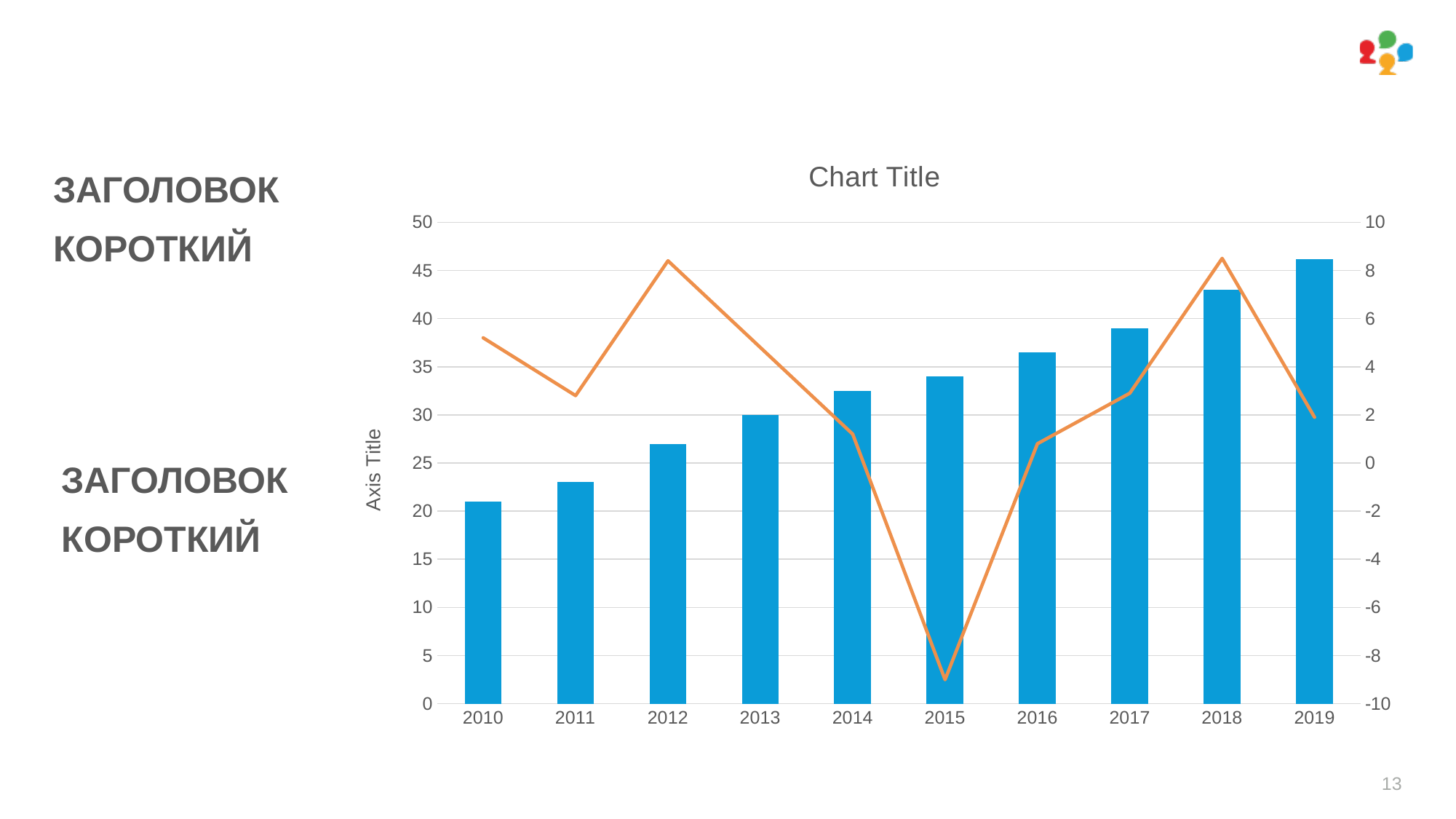
Which year has the tallest bar? 2019 Is the bar value for 2010 greater or less than 25? less What kind of chart is shown on the slide? bar chart with a line Which year has the larger bar value, 2014 or 2018? 2018 Which year has the shortest bar? 2010 On the right-hand axis, is the line value for 2012 greater or less than 6? greater How many years are shown on the x axis of the chart? 10 Do the bar values rise or fall from 2010 to 2019? rise What is the title shown above the chart? Chart Title In which year does the orange line reach its lowest point? 2015 On the right-hand axis, is the line value for 2015 greater or less than -5? less